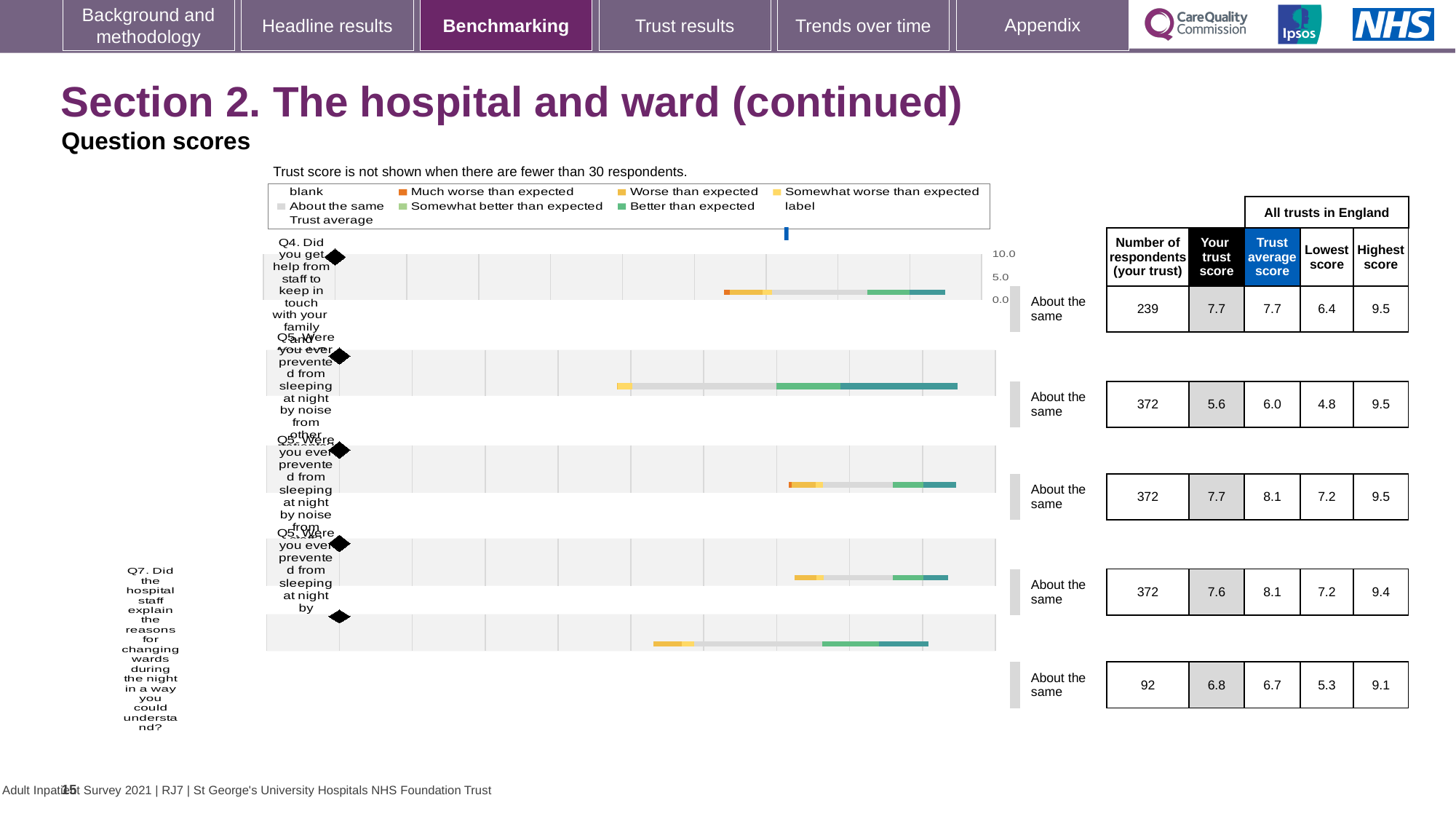
Which is larger, the trust score for Q4 or the trust score for Q7? Q4 What is the difference between the trust score and the trust average score for Q7? 0.1 What is the 'Your trust score' for Q4 (help from staff to keep in touch with family and friends)? 7.7 What is the maximum value shown on the score axis of the question scores chart? 10.0 What kind of chart is used to show the question scores on this slide? bar chart What benchmark category is shown for Q4? About the same Which question has the lowest number of respondents for this trust? Q7 What is the 'Your trust score' in the second row of the chart (Q5, noise from other patients), which has 372 respondents and a trust average of 6.0? 5.6 How many respondents answered Q4 for this trust? 239 What is the 'Your trust score' for Q7 (explaining reasons for changing wards during the night)? 6.8 How many question rows (bars) are plotted in the question scores chart? 5 What is the lowest score across all trusts in England for Q7? 5.3